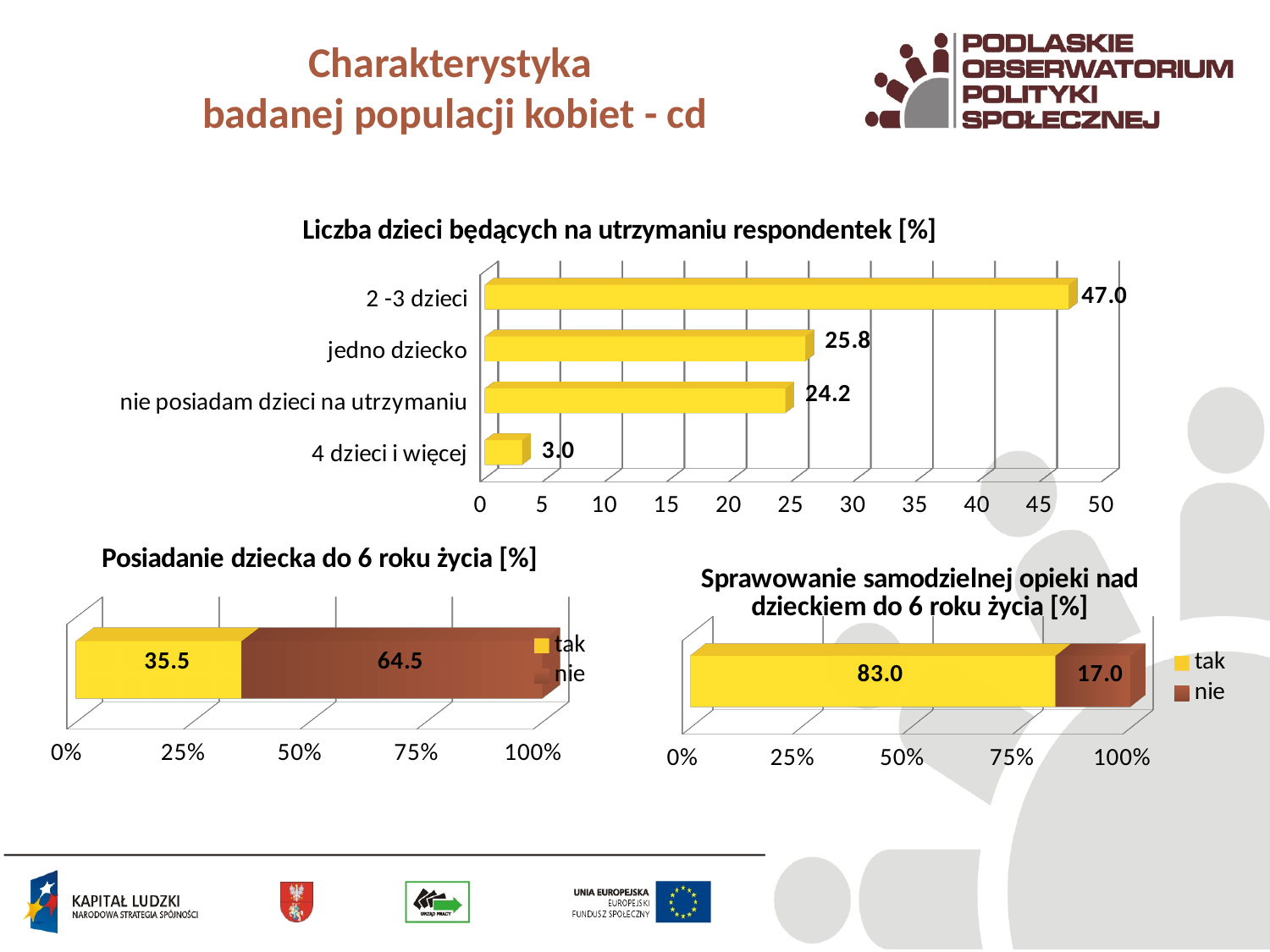
What kind of chart is 'Liczba dzieci będących na utrzymaniu respondentek [%]'? bar chart In the chart 'Liczba dzieci będących na utrzymaniu respondentek [%]', which category has the lowest value? 4 dzieci i więcej In the chart 'Liczba dzieci będących na utrzymaniu respondentek [%]', what is the difference between 'jedno dziecko' and 'nie posiadam dzieci na utrzymaniu'? 1.6 In the chart 'Posiadanie dziecka do 6 roku życia [%]', which is larger, 'tak' or 'nie'? nie In the chart 'Posiadanie dziecka do 6 roku życia [%]', what is the value for 'nie'? 64.5 In the chart 'Sprawowanie samodzielnej opieki nad dzieckiem do 6 roku życia [%]', what is the value for 'tak'? 83.0 How many series does the legend of the chart 'Sprawowanie samodzielnej opieki nad dzieckiem do 6 roku życia [%]' list? 2 In the chart 'Liczba dzieci będących na utrzymaniu respondentek [%]', which category has the highest value? 2 -3 dzieci In the chart 'Liczba dzieci będących na utrzymaniu respondentek [%]', how many categories are shown? 4 In the chart 'Posiadanie dziecka do 6 roku życia [%]', what colour is the 'tak' segment? yellow In the chart 'Sprawowanie samodzielnej opieki nad dzieckiem do 6 roku życia [%]', what is the difference between 'tak' and 'nie'? 66.0 In the chart 'Liczba dzieci będących na utrzymaniu respondentek [%]', what is the value for '2 -3 dzieci'? 47.0